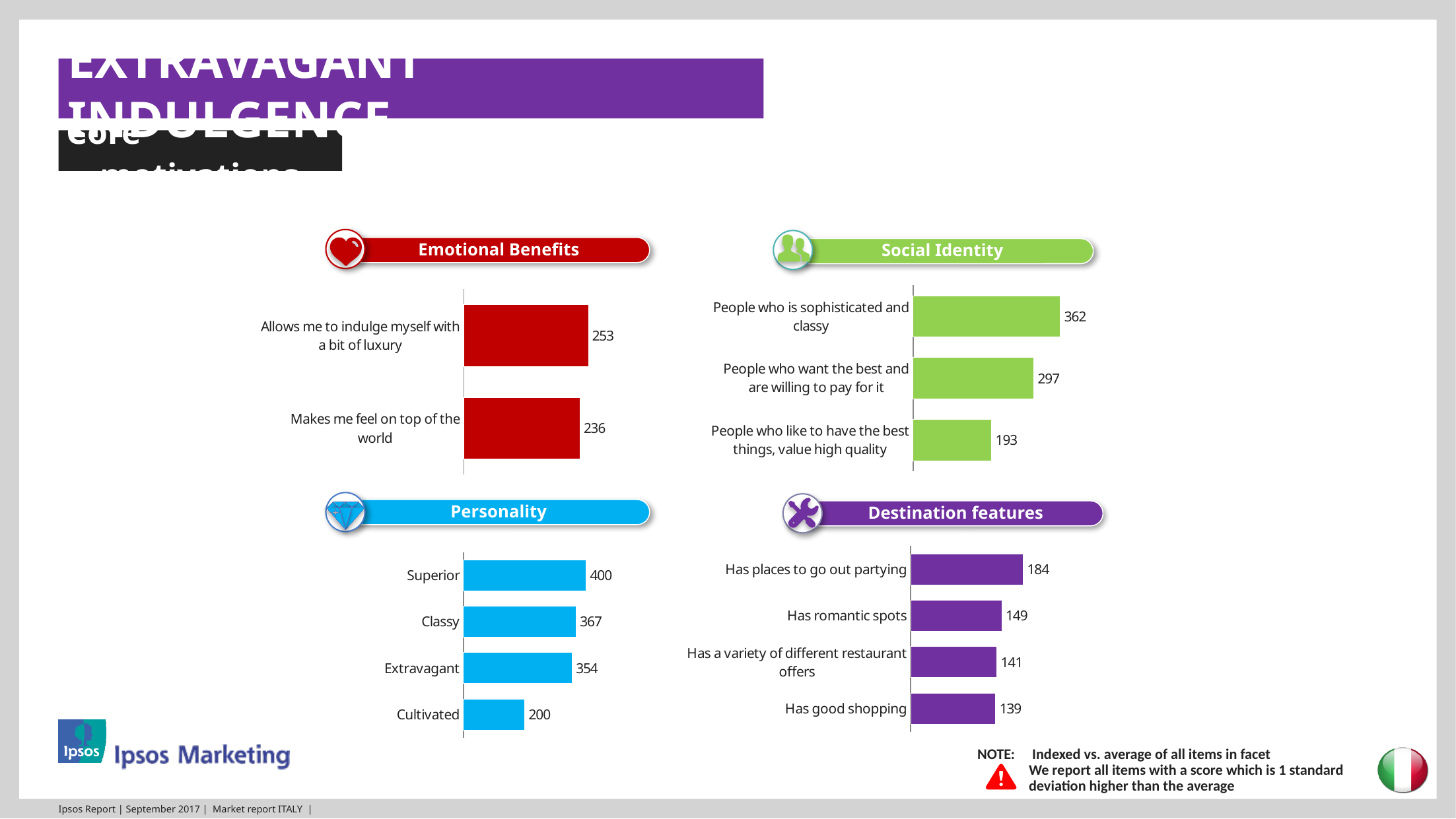
In the Personality chart, which category has the lowest value? Cultivated In the Destination features chart, what is the difference between "Has places to go out partying" and "Has good shopping"? 45 In the Social Identity chart, what is the value for "People who like to have the best things, value high quality"? 193 What type of chart is the Personality chart? Bar chart In the Personality chart, what is the value for "Superior"? 400 In the Emotional Benefits chart, what is the value for "Allows me to indulge myself with a bit of luxury"? 253 In the Personality chart, which is larger: Classy or Extravagant? Classy In the Destination features chart, what is the value for "Has romantic spots"? 149 In the Social Identity chart, how many categories are shown? 3 In the Social Identity chart, which category has the highest value? People who is sophisticated and classy In the Emotional Benefits chart, what is the difference between the two bars? 17 In the Destination features chart, how many categories are shown? 4